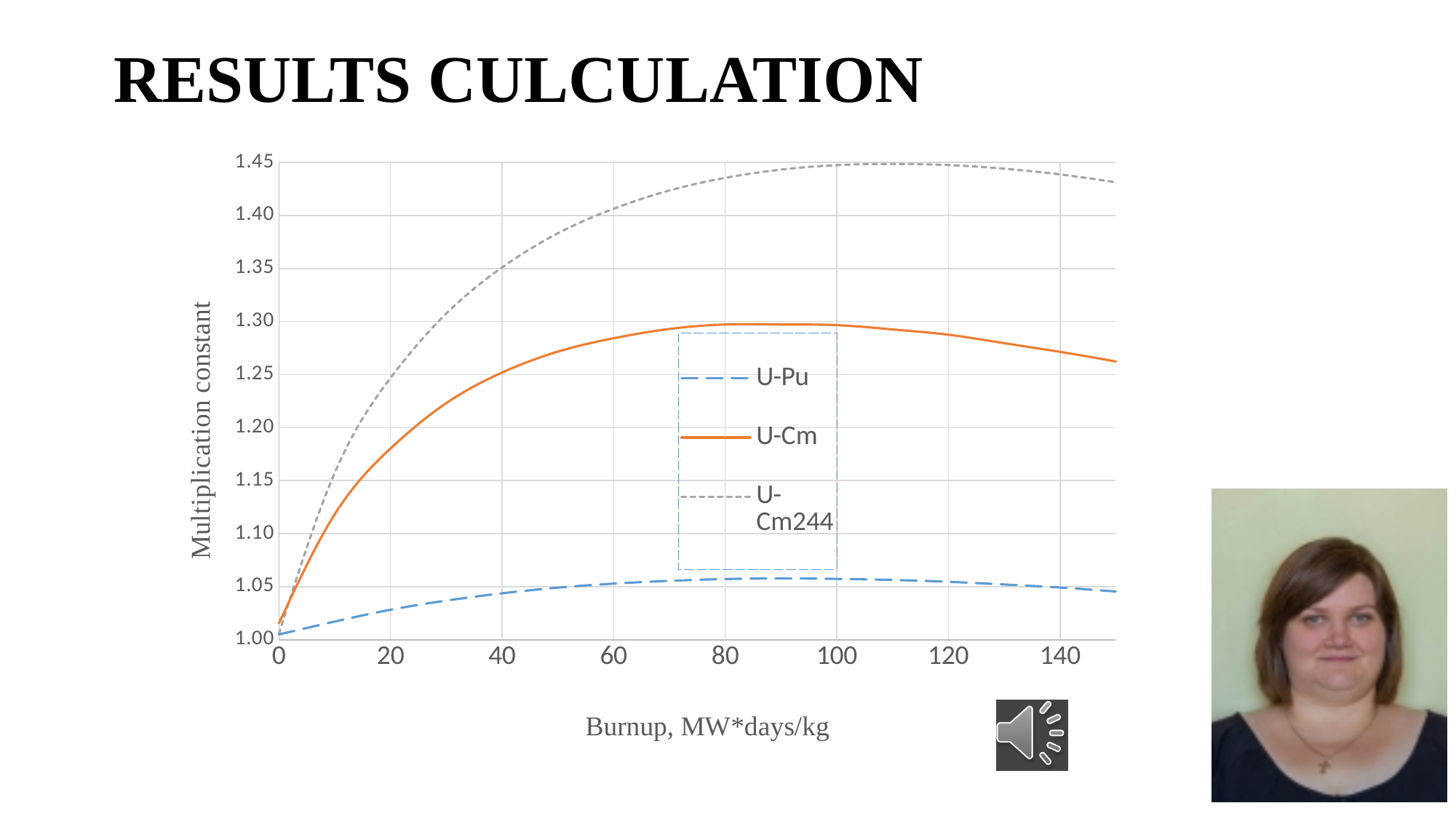
Which series has the highest multiplication constant across the burnup range? U-Cm244 Is the value for U-Cm at a burnup of 100 greater or less than 1.25? greater Is the value for U-Cm244 at a burnup of 20 greater or less than 1.20? greater Is the value for U-Cm244 at a burnup of 100 greater or less than 1.40? greater Does the U-Cm244 series rise or fall as burnup increases from 0 to 100? rise Which series has the lowest multiplication constant across the burnup range? U-Pu What is the label of the x axis? Burnup, MW*days/kg What are the three series named in the legend? U-Pu, U-Cm, U-Cm244 How many series does the legend list? 3 At a burnup of 100, which is larger: the value for U-Cm244 or the value for U-Pu? U-Cm244 What kind of chart is shown on the slide? line chart